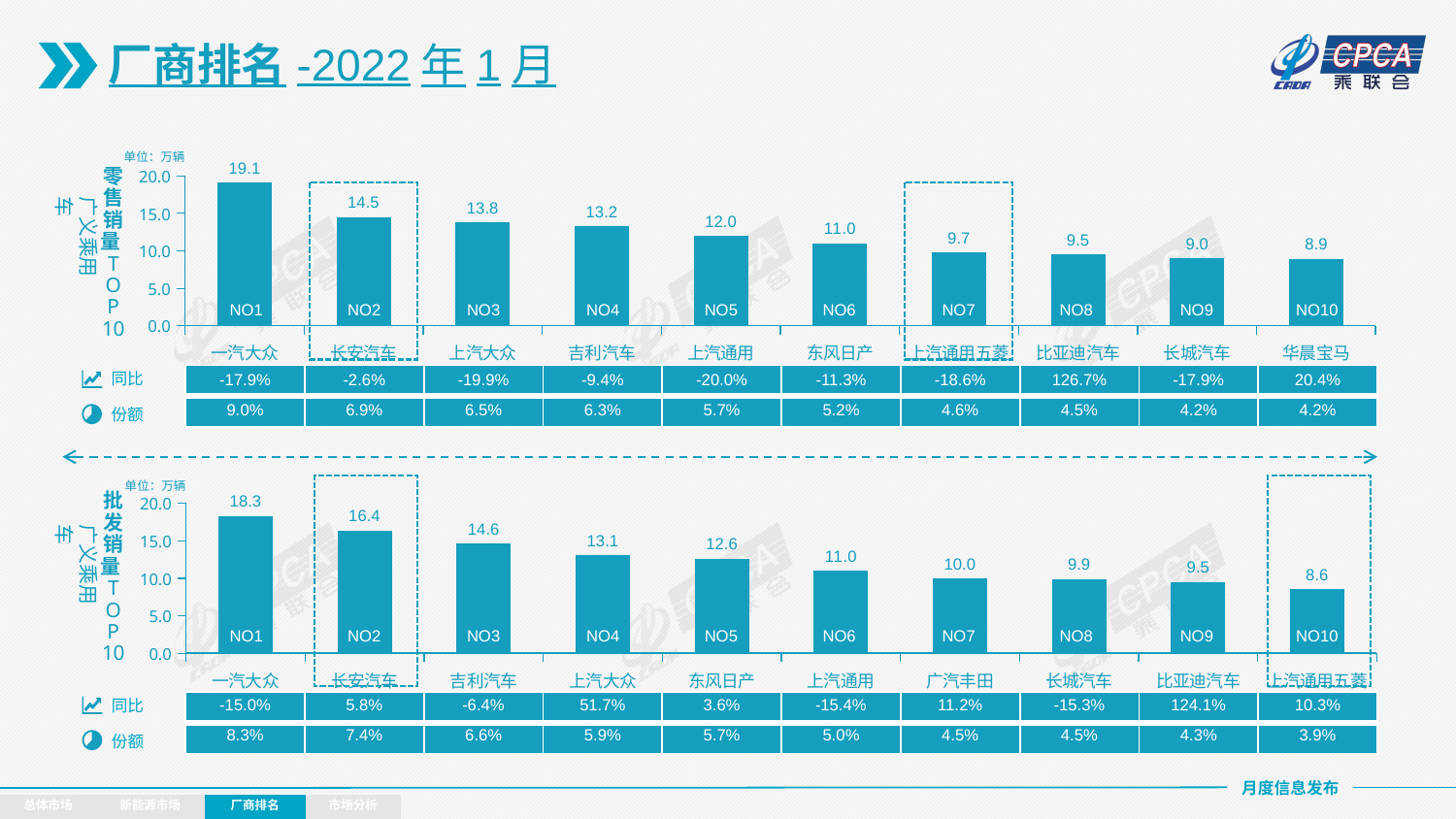
In the bottom chart (批发销量 TOP 10), do the values rise or fall from NO1 to NO10? fall In the bottom chart (批发销量 TOP 10), what is the difference between 长安汽车 and 上汽大众? 3.3 How many manufacturers are shown in the top chart (零售销量 TOP 10)? 10 In the top chart (零售销量 TOP 10), which manufacturer has the highest value? 一汽大众 In the bottom chart (批发销量 TOP 10), which is larger, 东风日产 or 上汽通用? 东风日产 In the top chart (零售销量 TOP 10), what is the value for 一汽大众? 19.1 In the top chart (零售销量 TOP 10), what is the difference between 一汽大众 and 长安汽车? 4.6 In the bottom chart (批发销量 TOP 10), what is the value for 吉利汽车? 14.6 What type of chart is the bottom chart (批发销量 TOP 10)? bar chart In the bottom chart (批发销量 TOP 10), which manufacturer has the lowest value? 上汽通用五菱 In the top chart (零售销量 TOP 10), is the value for 东风日产 greater or less than 10.0? greater In the top chart (零售销量 TOP 10), what is the value for 上汽通用五菱? 9.7